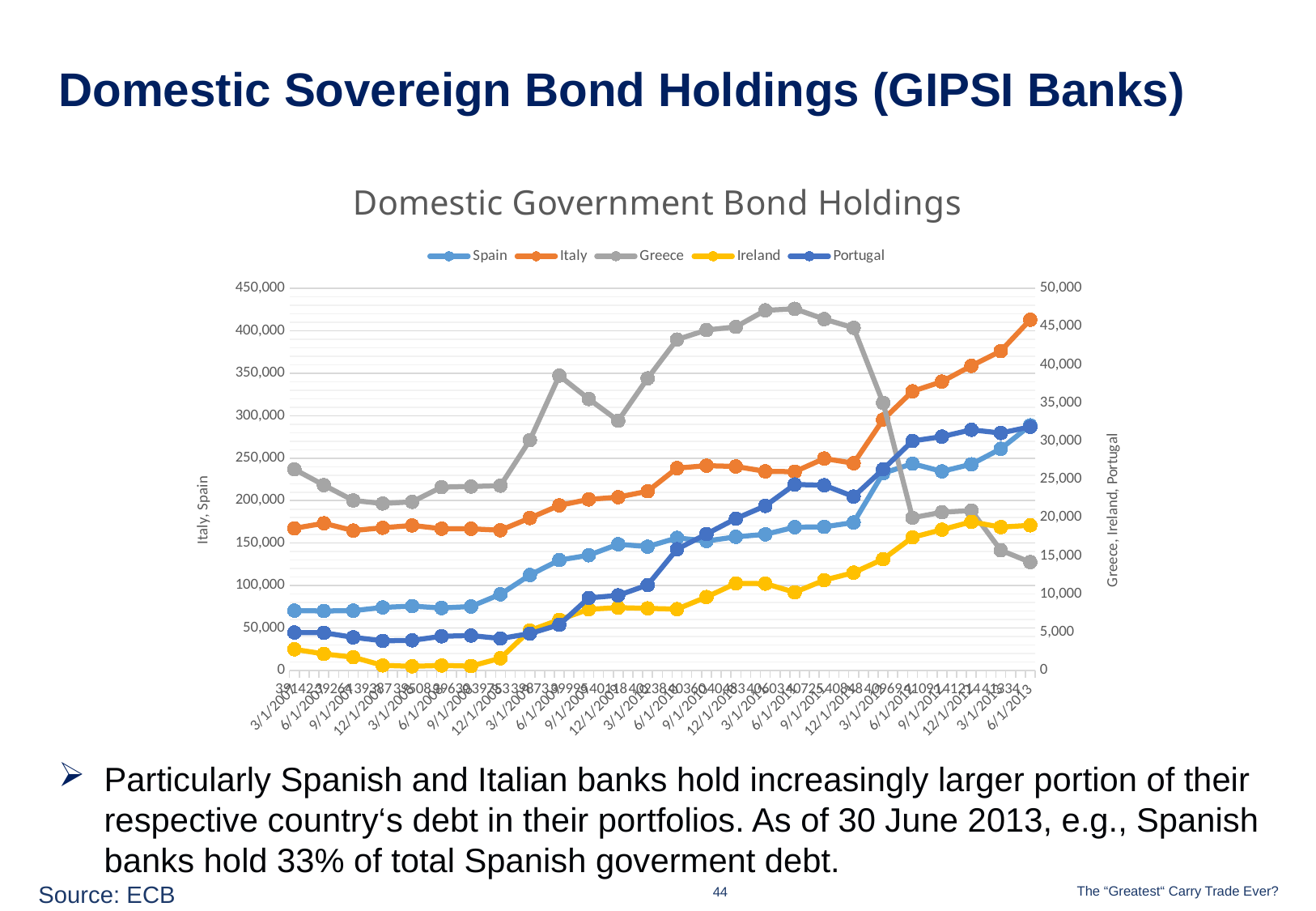
Does the Greece series rise or fall between 6/1/2011 and 6/1/2013? fall Is the value for Italy at 6/1/2013 greater or less than 400,000? greater At 6/1/2013, which is larger, the value for Italy or the value for Spain? Italy Is the value for Portugal at 6/1/2013 greater or less than 30,000 on the right axis? greater Is the value for Greece at 6/1/2013 greater or less than 20,000 on the right axis? less How many series does the legend list? 5 What kind of chart is shown on the slide? Line chart What is the title of the right-hand vertical axis? Greece, Ireland, Portugal Which countries are listed in the chart legend? Spain, Italy, Greece, Ireland, Portugal